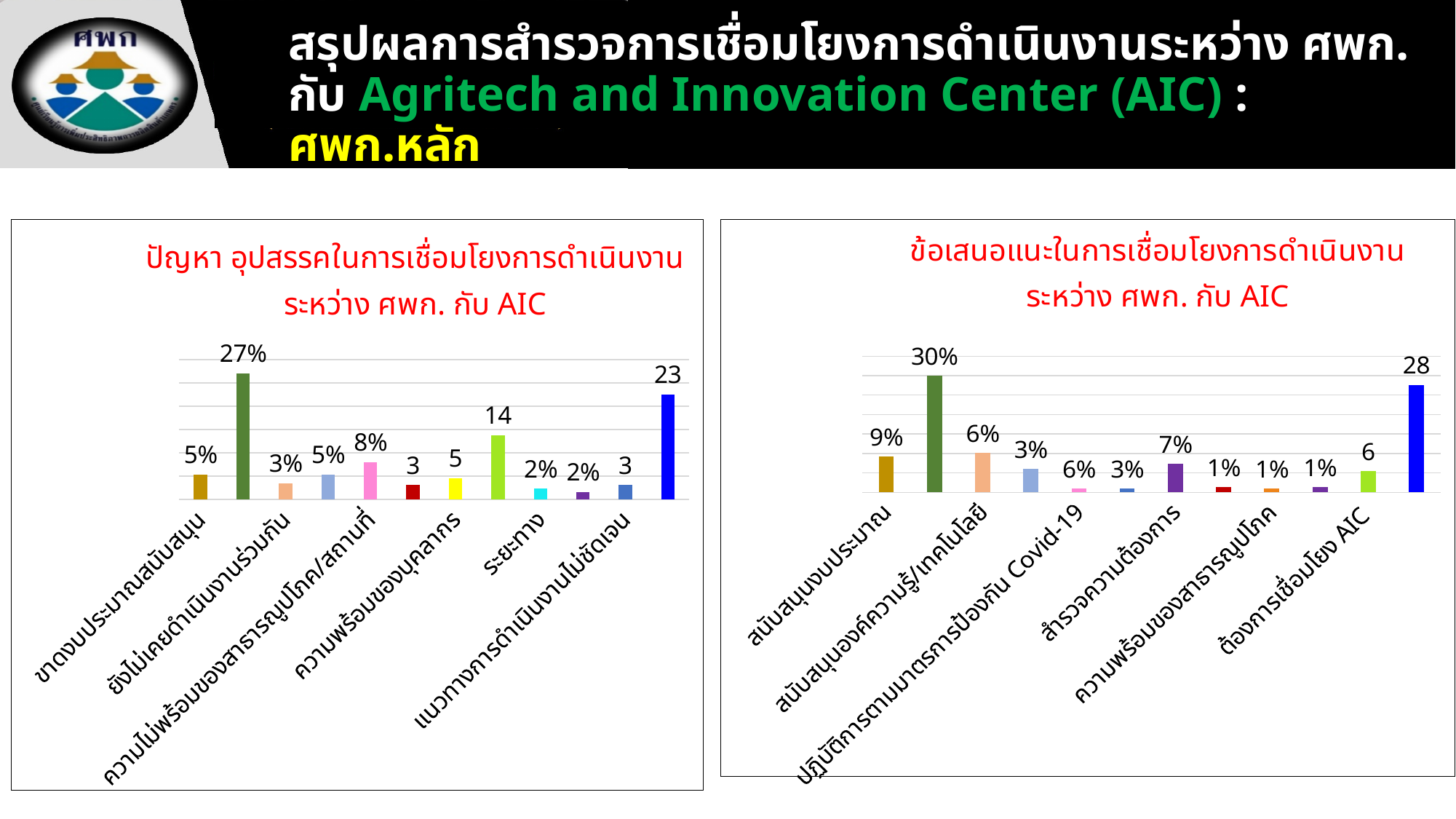
In the left chart (ปัญหา อุปสรรค), what is the data label on the light-green bar above ระยะทาง? 14 What type of chart is the right chart titled "ข้อเสนอแนะในการเชื่อมโยงการดำเนินงานระหว่าง ศพก. กับ AIC"? Bar chart In the left chart (ปัญหา อุปสรรค), what is the data label on the last (blue) bar on the right? 23 In the left chart (ปัญหา อุปสรรค), what is the value of the first bar, labelled ขาดงบประมาณสนับสนุน? 5% In the right chart (ข้อเสนอแนะ), what is the highest percentage label shown? 30% What type of chart is the left chart titled "ปัญหา อุปสรรคในการเชื่อมโยงการดำเนินงานระหว่าง ศพก. กับ AIC"? Bar chart How many bars are plotted in the left chart (ปัญหา อุปสรรค)? 12 How many bars are plotted in the right chart (ข้อเสนอแนะ)? 12 In the right chart (ข้อเสนอแนะ), what is the data label on the last (blue) bar on the right? 28 In the right chart (ข้อเสนอแนะ), what is the difference between the 30% bar and the 9% bar labelled สนับสนุนงบประมาณ? 21% In the right chart (ข้อเสนอแนะ), what is the value of the first bar, labelled สนับสนุนงบประมาณ? 9% In the left chart (ปัญหา อุปสรรค), what is the highest data label shown? 27%